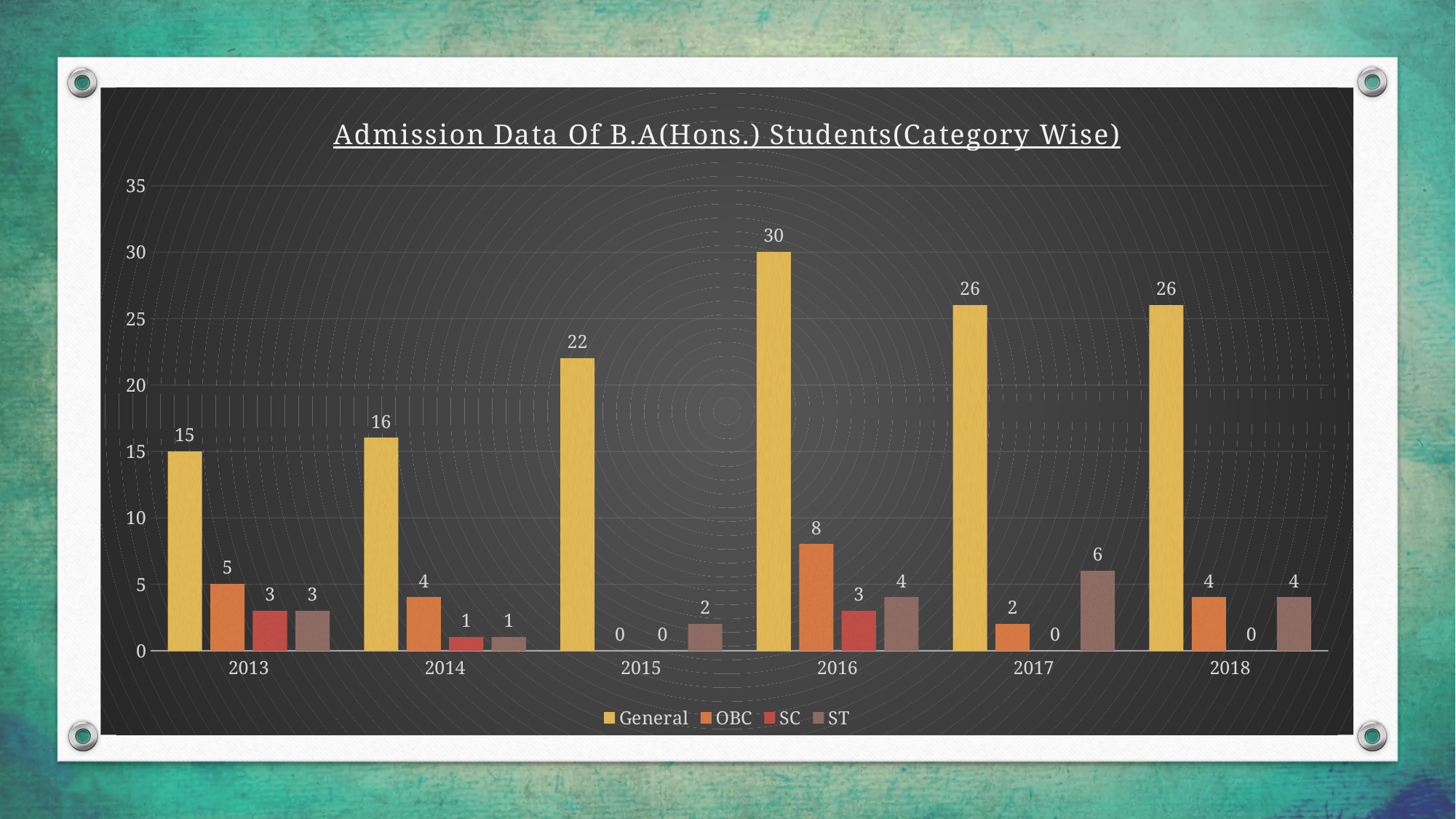
What kind of chart is shown on the slide? Bar chart How many years are shown on the x axis? 6 Which is larger, the OBC value in 2016 or the OBC value in 2014? OBC in 2016 How many series does the legend list? 4 In which year is the General value lowest? 2013 What is the value for ST in 2017? 6 What is the value for General in 2016? 30 What is the value for SC in 2015? 0 What is the value for OBC in 2013? 5 What is the difference between the General values for 2016 and 2015? 8 In which year is the General value highest? 2016 What is the title of the chart? Admission Data Of B.A(Hons.) Students(Category Wise)